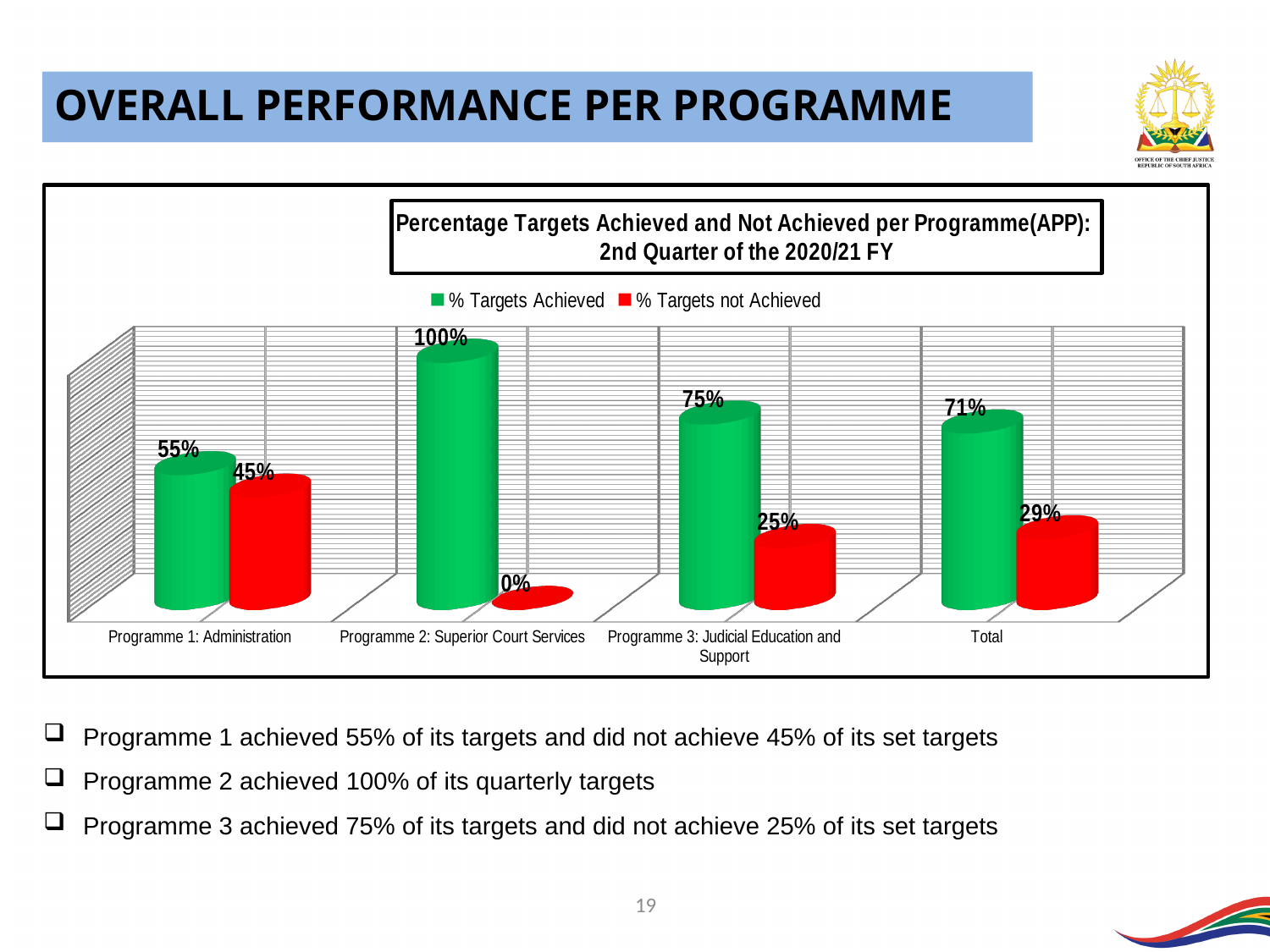
What is the difference between % Targets Achieved and % Targets not Achieved for Programme 1: Administration? 10% Which programme has the highest % Targets Achieved? Programme 2: Superior Court Services What kind of chart is shown on the slide? Bar chart How many series does the chart legend list? 2 Which colour represents % Targets not Achieved in the chart? Red Which category has the lowest % Targets not Achieved? Programme 2: Superior Court Services What is the % Targets not Achieved value for Programme 3: Judicial Education and Support? 25% Which is larger: % Targets Achieved for Programme 3: Judicial Education and Support or for Total? Programme 3: Judicial Education and Support What percentage of targets were not achieved by Programme 1: Administration? 45% What is the % Targets Achieved value for Total? 71% What percentage of targets were achieved by Programme 2: Superior Court Services? 100% How many categories are shown on the x axis of the chart? 4